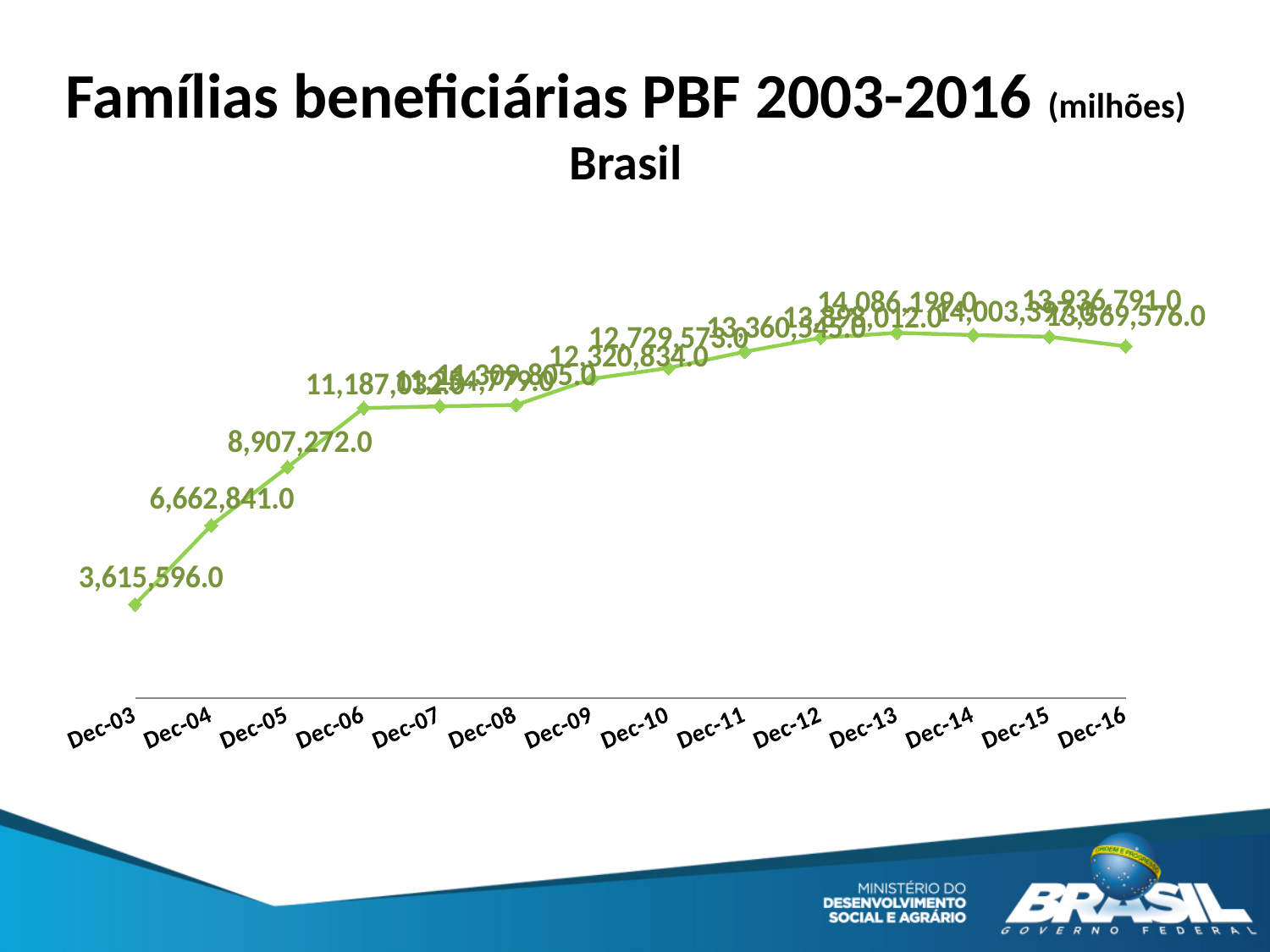
Which is larger, the value for Dec-05 or the value for Dec-04? Dec-05 What is the value for Dec-05? 8,907,272.0 What is the value for Dec-16? 13,569,576.0 What is the difference between the values for Dec-05 and Dec-04? 2,244,431.0 Which date has the lowest value? Dec-03 What kind of chart is shown on the slide? Line chart What is the value for Dec-03? 3,615,596.0 How many data points are plotted on the chart? 14 What is the title of the chart? Famílias beneficiárias PBF 2003-2016 (milhões) Brasil Which date has the highest value? Dec-13 What is the value for Dec-04? 6,662,841.0 What is the difference between the values for Dec-04 and Dec-03? 3,047,245.0